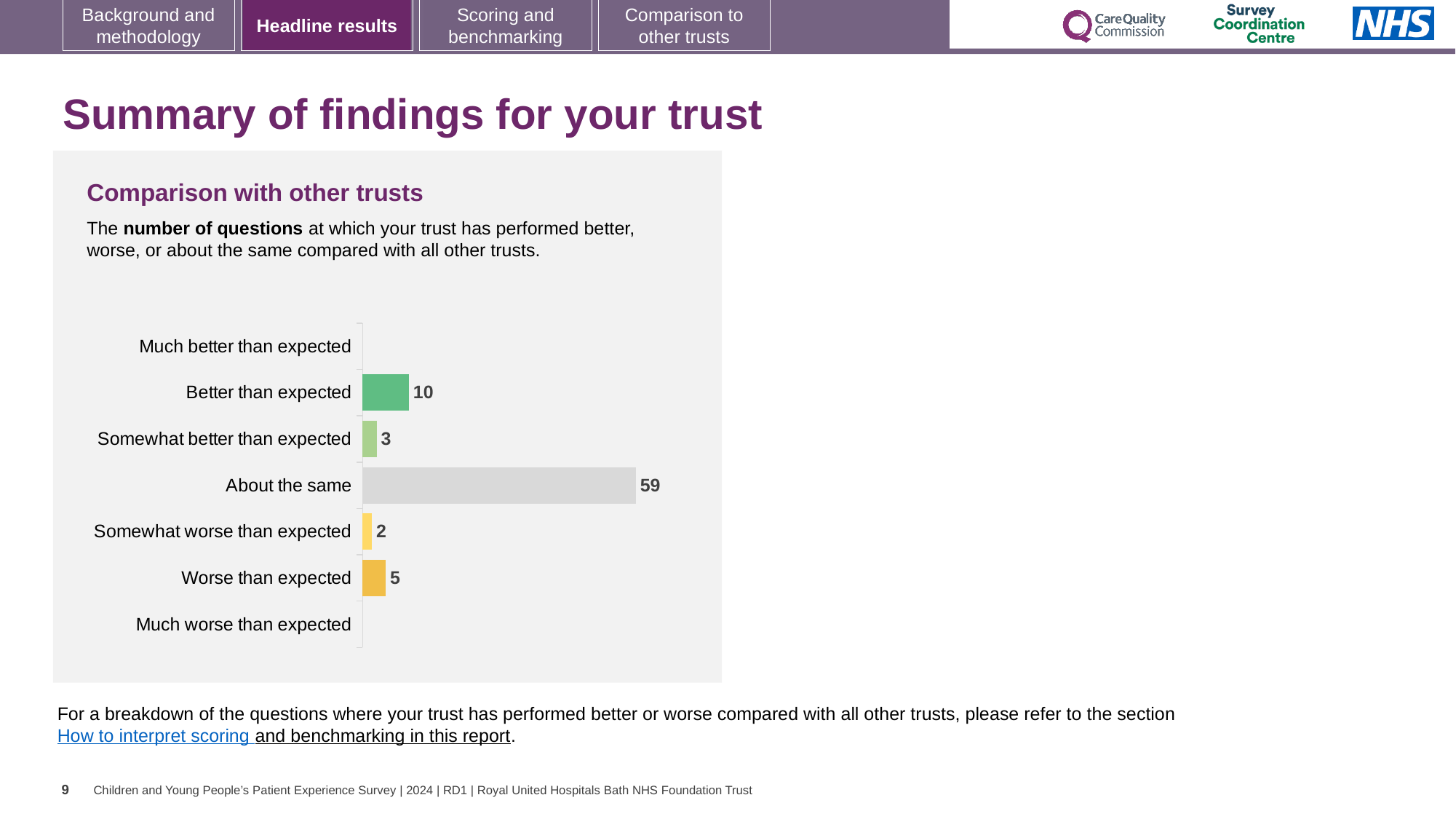
Which category has the highest number of questions? About the same What is the title of the chart section? Comparison with other trusts How many questions were rated 'About the same'? 59 What is the difference between 'Better than expected' and 'Worse than expected'? 5 What is the value for 'Worse than expected'? 5 What is the value for 'Somewhat worse than expected'? 2 What kind of chart is shown? Bar chart Which is larger: 'Somewhat better than expected' or 'Somewhat worse than expected'? Somewhat better than expected What is the value for 'Better than expected'? 10 How many categories are listed on the chart's axis? 7 What is the total number of questions rated 'Better than expected' and 'Somewhat better than expected' combined? 13 What is the difference between 'About the same' and 'Better than expected'? 49